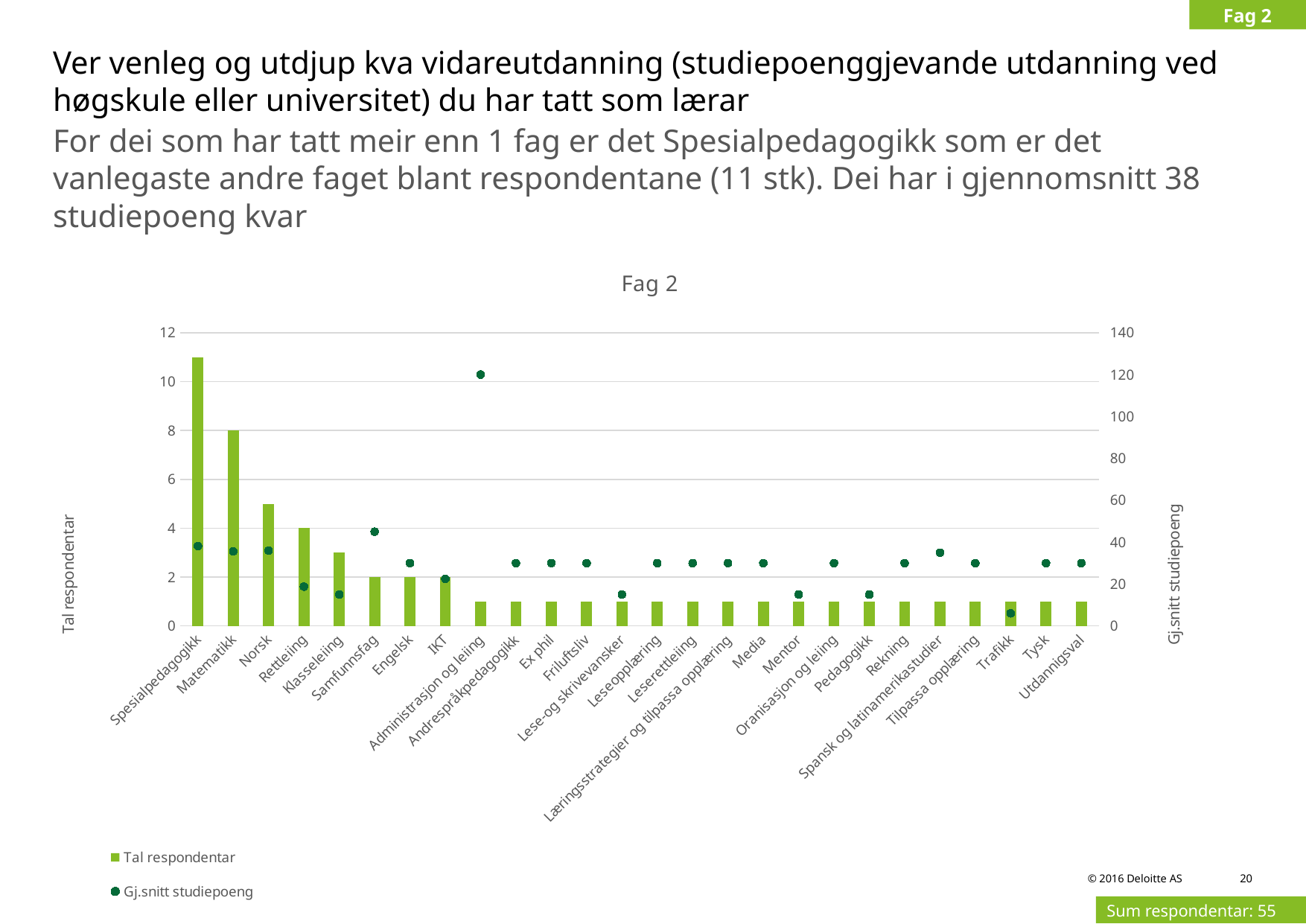
What is the title of the right-hand (secondary) vertical axis of the 'Fag 2' chart? Gj.snitt studiepoeng Is the Gj.snitt studiepoeng value for Administrasjon og leiing greater or less than 100? greater What kind of chart is the 'Fag 2' chart? bar chart Which category has the highest number of respondents (Tal respondentar) in the 'Fag 2' chart? Spesialpedagogikk Which has more respondents in the 'Fag 2' chart, Norsk or Rettleiing? Norsk What is the difference in number of respondents between Spesialpedagogikk and Matematikk in the 'Fag 2' chart? 3 How many series does the legend of the 'Fag 2' chart list? 2 How many categories are shown on the x axis of the 'Fag 2' chart? 26 Which category has the highest Gj.snitt studiepoeng value in the 'Fag 2' chart? Administrasjon og leiing How many respondents (Tal respondentar) are shown for Rettleiing in the 'Fag 2' chart? 4 How many respondents chose Spesialpedagogikk as their second subject, according to the slide? 11 How many respondents (Tal respondentar) are shown for Matematikk in the 'Fag 2' chart? 8